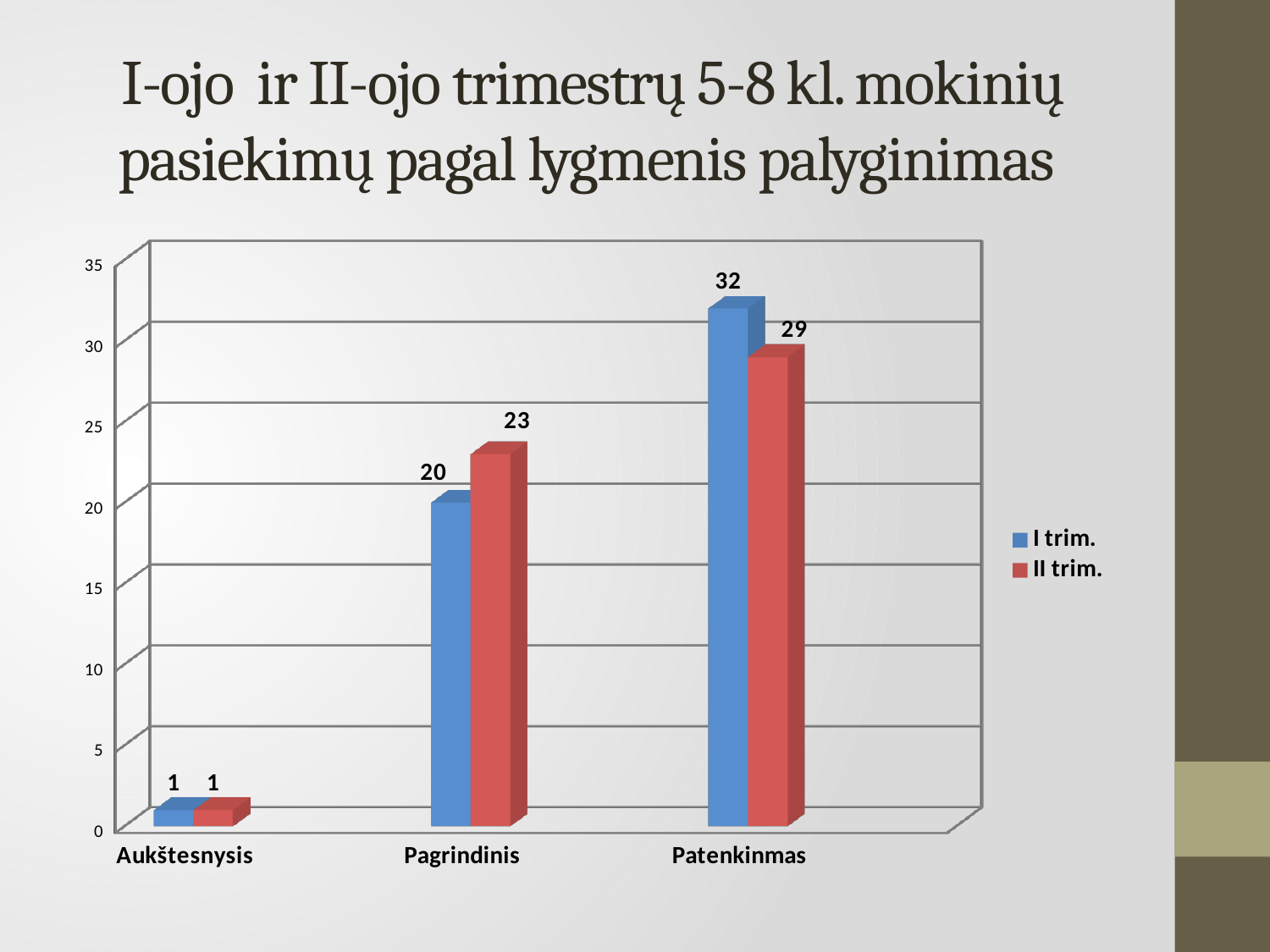
What is the difference between the I trim. and II trim. values for Patenkinmas? 3 What is the value for Patenkinmas in the II trim. series? 29 For Pagrindinis, which series has the larger value, I trim. or II trim.? II trim. What is the value for Pagrindinis in the I trim. series? 20 What is the difference between the II trim. and I trim. values for Pagrindinis? 3 What kind of chart is shown on the slide? Bar chart For Patenkinmas, which series has the larger value, I trim. or II trim.? I trim. What is the value for Aukštesnysis in the I trim. series? 1 Which category has the lowest value in the II trim. series? Aukštesnysis How many categories are shown on the x axis? 3 Which category has the highest value in the I trim. series? Patenkinmas How many series does the legend list? 2